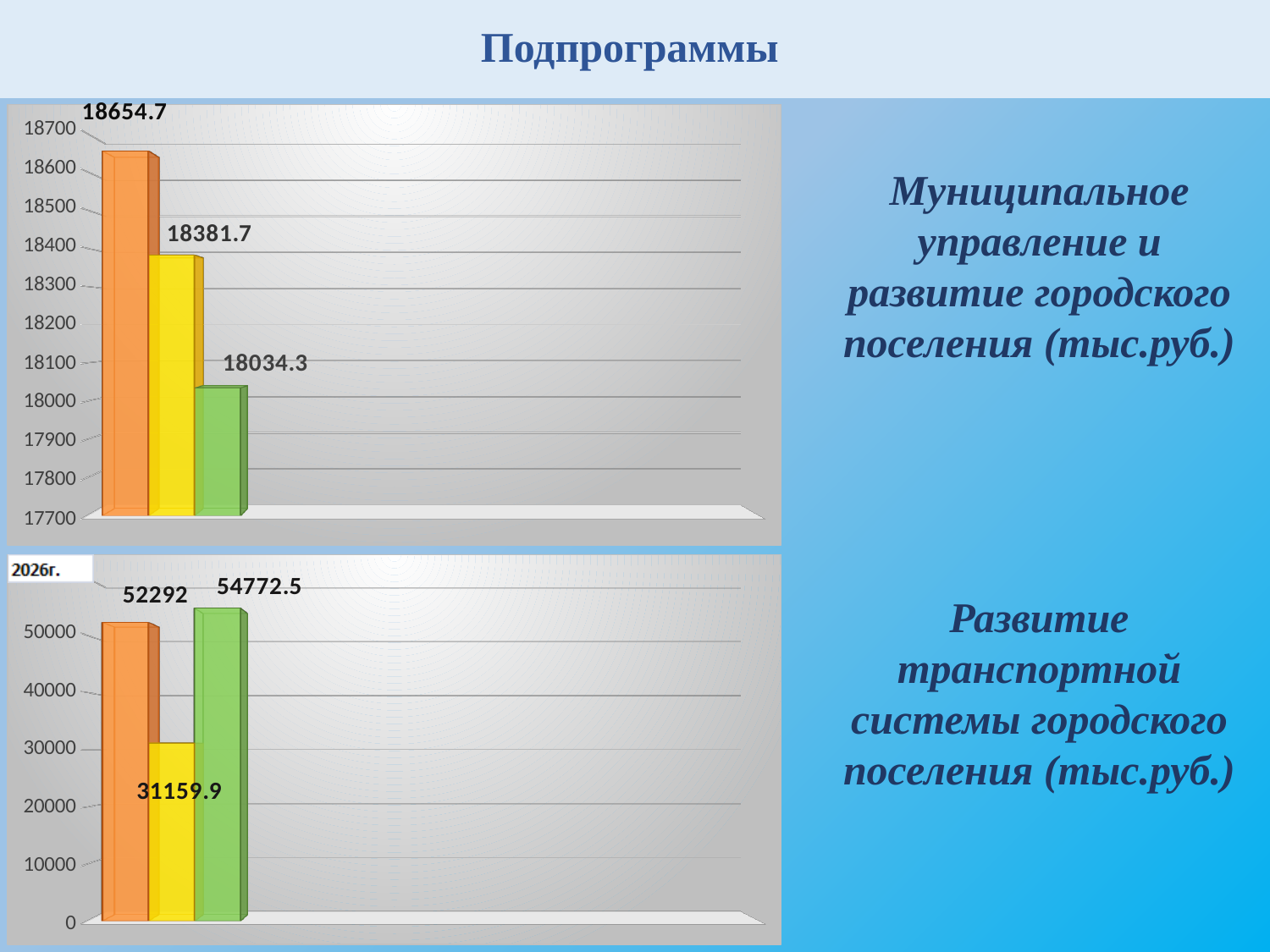
What kind of chart is the top chart? Bar chart In the top chart, what is the difference between the first (orange) bar and the third (green) bar? 620.4 In the top chart, what value is labelled on the third (green) bar? 18034.3 In the bottom chart, which is larger: the first (orange) bar or the third (green) bar? The third (green) bar In the bottom chart, what is the difference between the third (green) bar and the first (orange) bar? 2480.5 In the top chart, what value is labelled on the first (orange) bar? 18654.7 How many bars are plotted in the top chart? 3 In the bottom chart, which bar has the lowest value? The second (yellow) bar In the top chart, do the values rise or fall from the first bar to the third bar? Fall In the top chart, which bar has the highest value? The first (orange) bar In the bottom chart, is the value of the second (yellow) bar greater or less than 40000? less In the bottom chart, what value is labelled on the second (yellow) bar? 31159.9